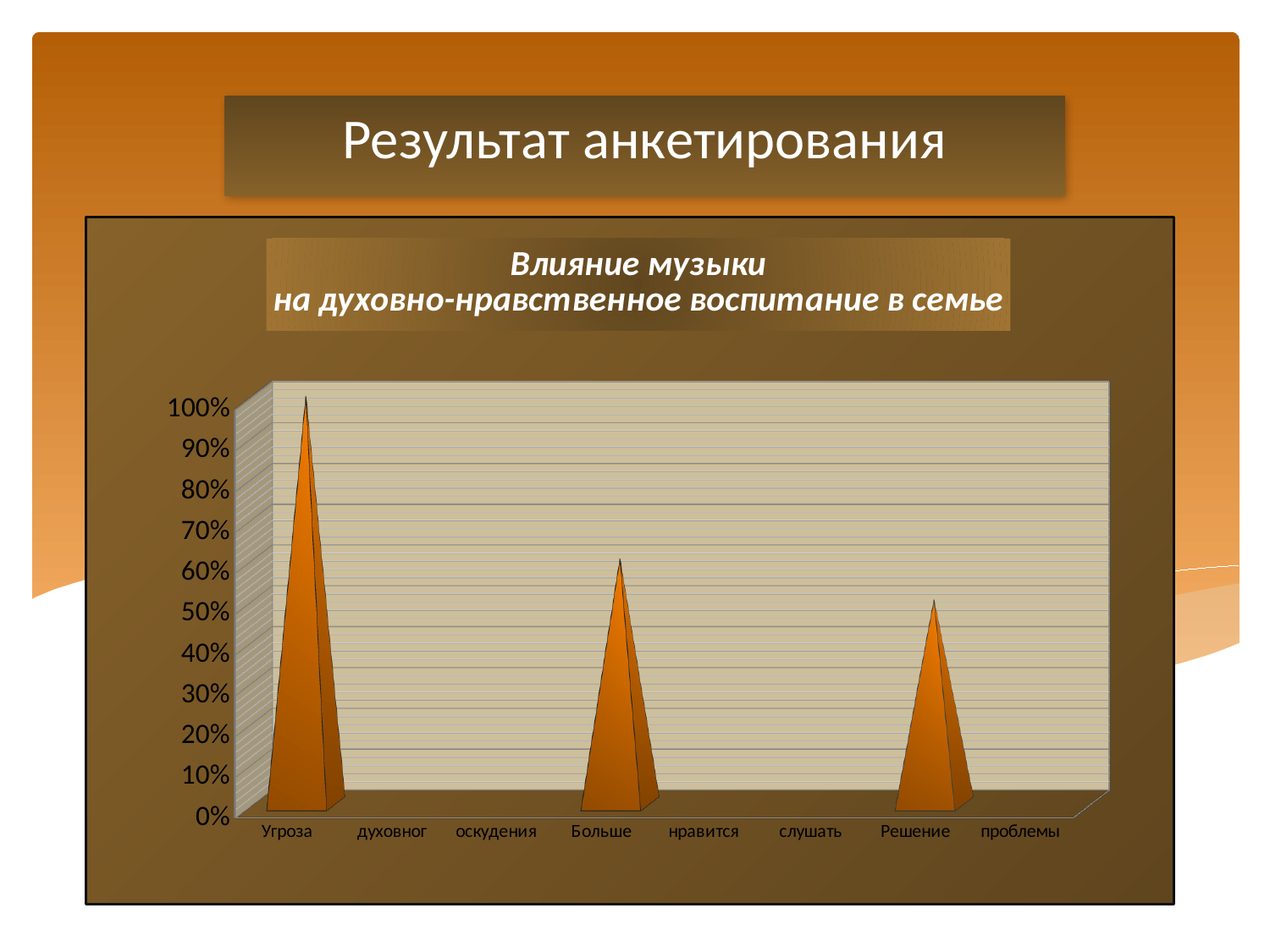
What kind of chart is shown on the slide? Bar chart Is the value for 'Решение проблемы' greater or less than 30%? greater Is the value for 'Больше нравится слушать' greater or less than 40%? greater Is the value for 'Угроза духовного оскудения' greater or less than 90%? greater What is the title of the chart? Влияние музыки на духовно-нравственное воспитание в семье Which category has the highest value in the chart? Угроза духовног оскудения Do the values rise or fall from left to right across the categories? fall What colour are the bars in the chart? Orange How many categories are plotted in the chart? 3 Which category has the lowest value in the chart? Решение проблемы Which is larger: the value for 'Больше нравится слушать' or the value for 'Решение проблемы'? Больше нравится слушать